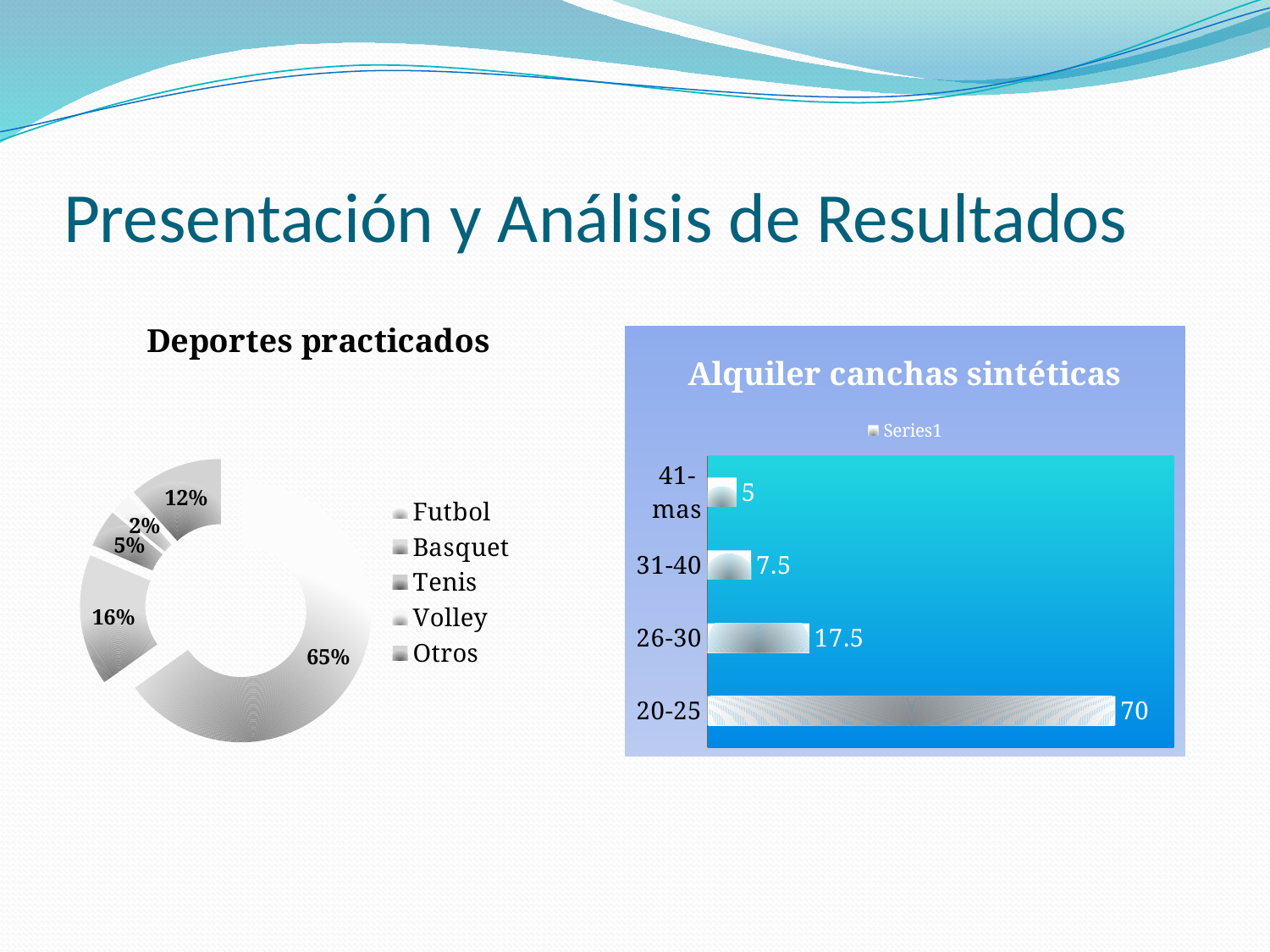
What type of chart is 'Alquiler canchas sintéticas'? Bar chart How many entries does the legend of the 'Deportes practicados' chart list? 5 In the 'Deportes practicados' chart, what is the largest share shown? 65% In the 'Alquiler canchas sintéticas' chart, which category has the highest value? 20-25 In the 'Alquiler canchas sintéticas' chart, what is the difference between the values for 20-25 and 26-30? 52.5 In the 'Alquiler canchas sintéticas' chart, what is the value for the 31-40 category? 7.5 In the 'Deportes practicados' chart, what is the smallest share shown? 2% In the 'Alquiler canchas sintéticas' chart, what is the value for the 26-30 category? 17.5 In the 'Alquiler canchas sintéticas' chart, how many categories are shown? 4 In the 'Alquiler canchas sintéticas' chart, which category has the lowest value? 41-mas In the 'Alquiler canchas sintéticas' chart, what is the value for the 41-mas category? 5 In the 'Alquiler canchas sintéticas' chart, what is the value for the 20-25 category? 70